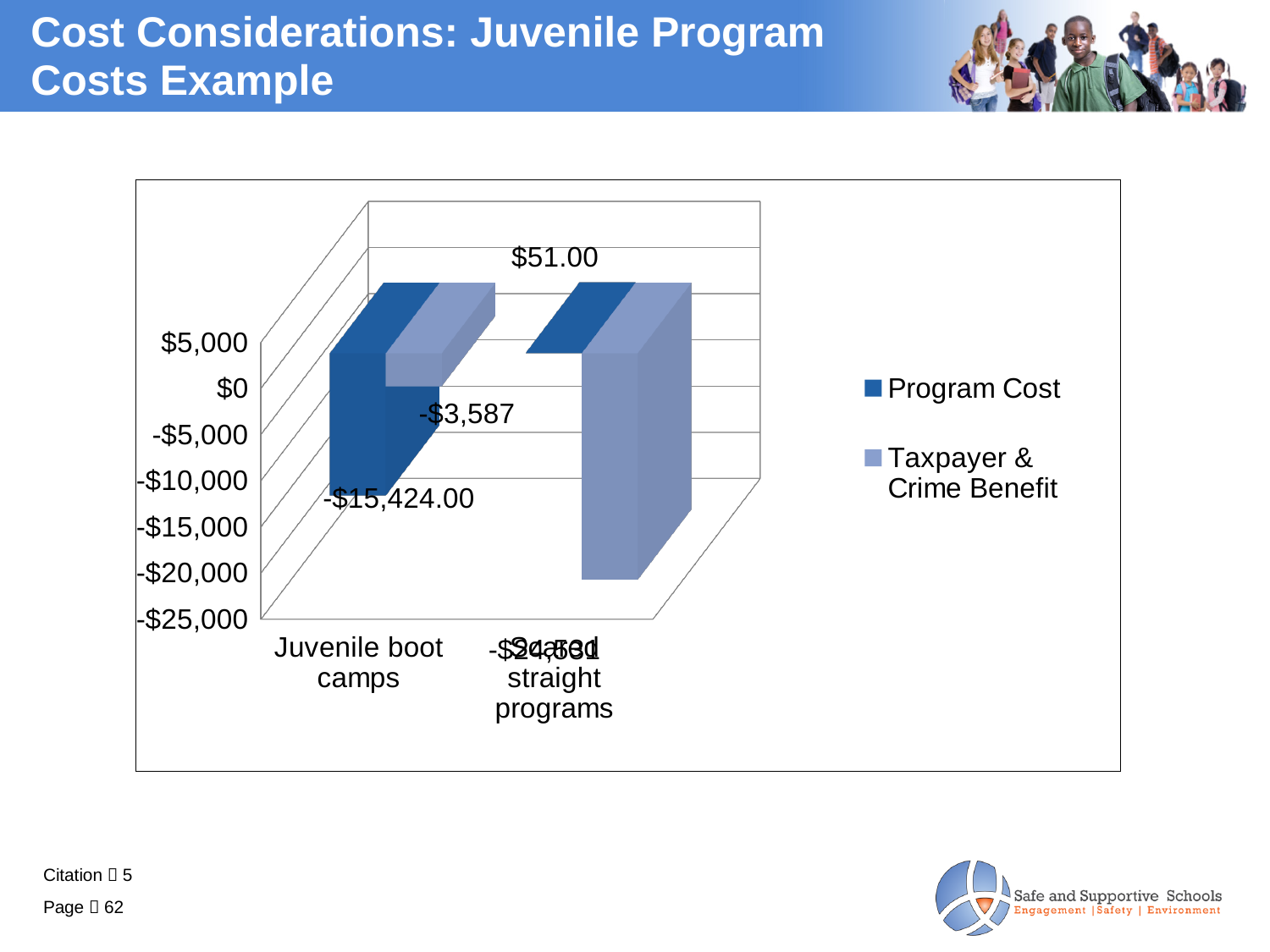
What is the Program Cost value for Scared straight programs? $51.00 What kind of chart is shown on the slide? Bar chart How many series does the legend list? 2 How many categories are shown on the x axis? 2 What are the two series named in the legend? Program Cost; Taxpayer & Crime Benefit Is the Program Cost value for Juvenile boot camps greater or less than -$10,000? less What is the Taxpayer & Crime Benefit value for Juvenile boot camps? -$3,587 What colour represents the Program Cost series? Dark blue Which category has the larger Program Cost value, Juvenile boot camps or Scared straight programs? Scared straight programs What is the difference between the Program Cost and the Taxpayer & Crime Benefit values for Juvenile boot camps? $11,837.00 What is the Program Cost value for Juvenile boot camps? -$15,424.00 Which bar has the highest value on the chart? Program Cost for Scared straight programs